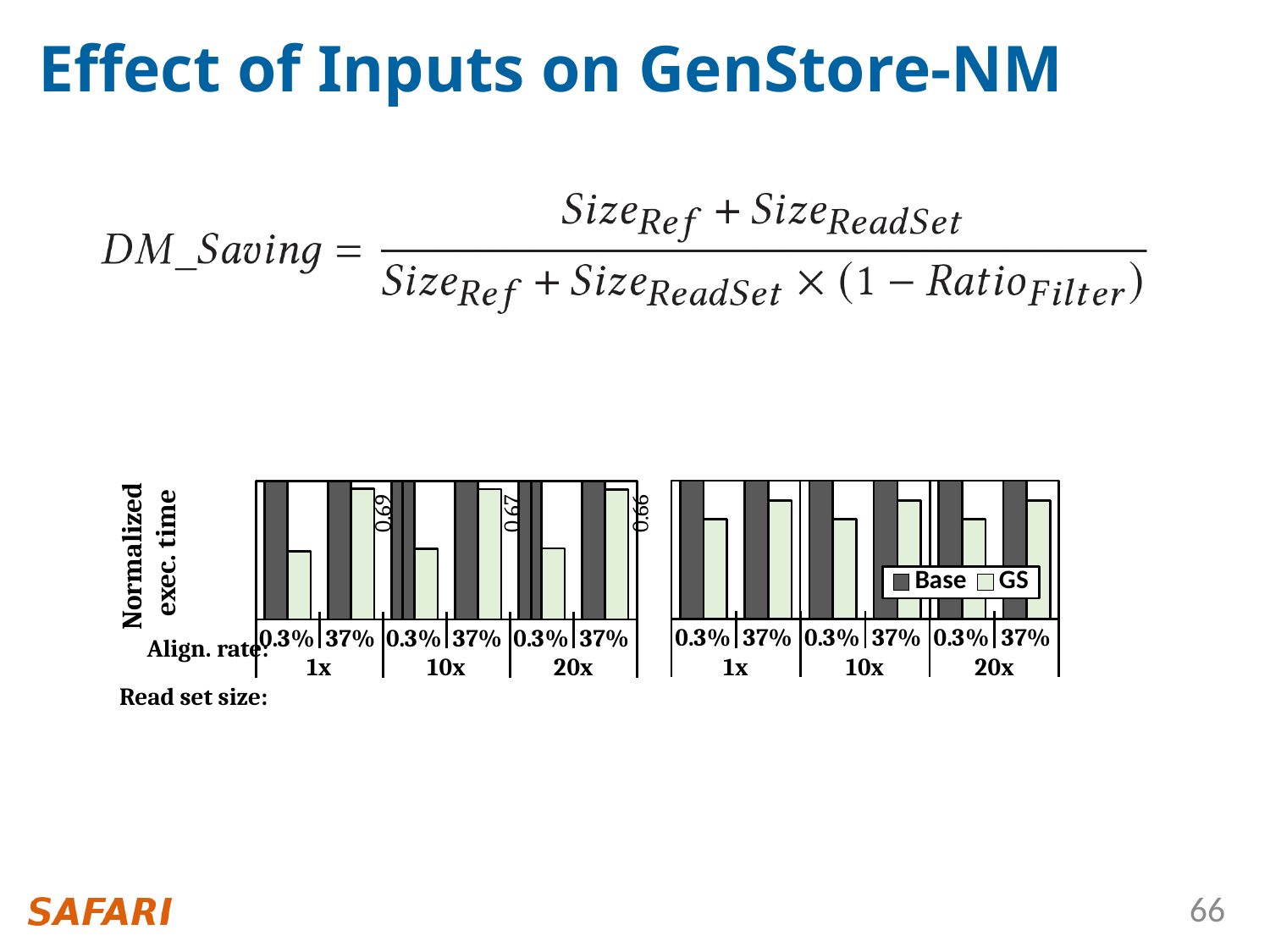
In the left chart, what is the labeled value of the GS bar at 37% align rate with a 1x read set size? 0.69 In the left chart, which read set size has the lowest labeled GS value at 37% align rate? 20x In the left chart, what is the labeled value of the GS bar at 37% align rate with a 20x read set size? 0.66 What type of chart is shown on the slide? bar chart In the left chart, for a 1x read set size, is the GS bar larger at 0.3% or at 37% align rate? 37% How many series does the legend list? 2 What is the label on the y axis of the charts? Normalized exec. time In the left chart, do the labeled GS values at 37% align rate rise or fall as the read set size increases from 1x to 20x? fall In the right chart, for a 10x read set size at 37% align rate, which is larger, the Base bar or the GS bar? Base In the left chart, what is the labeled value of the GS bar at 37% align rate with a 10x read set size? 0.67 In the left chart, what is the difference between the labeled GS values at 37% align rate for 1x and 20x read set sizes? 0.03 In the left chart, which read set size has the highest labeled GS value at 37% align rate? 1x